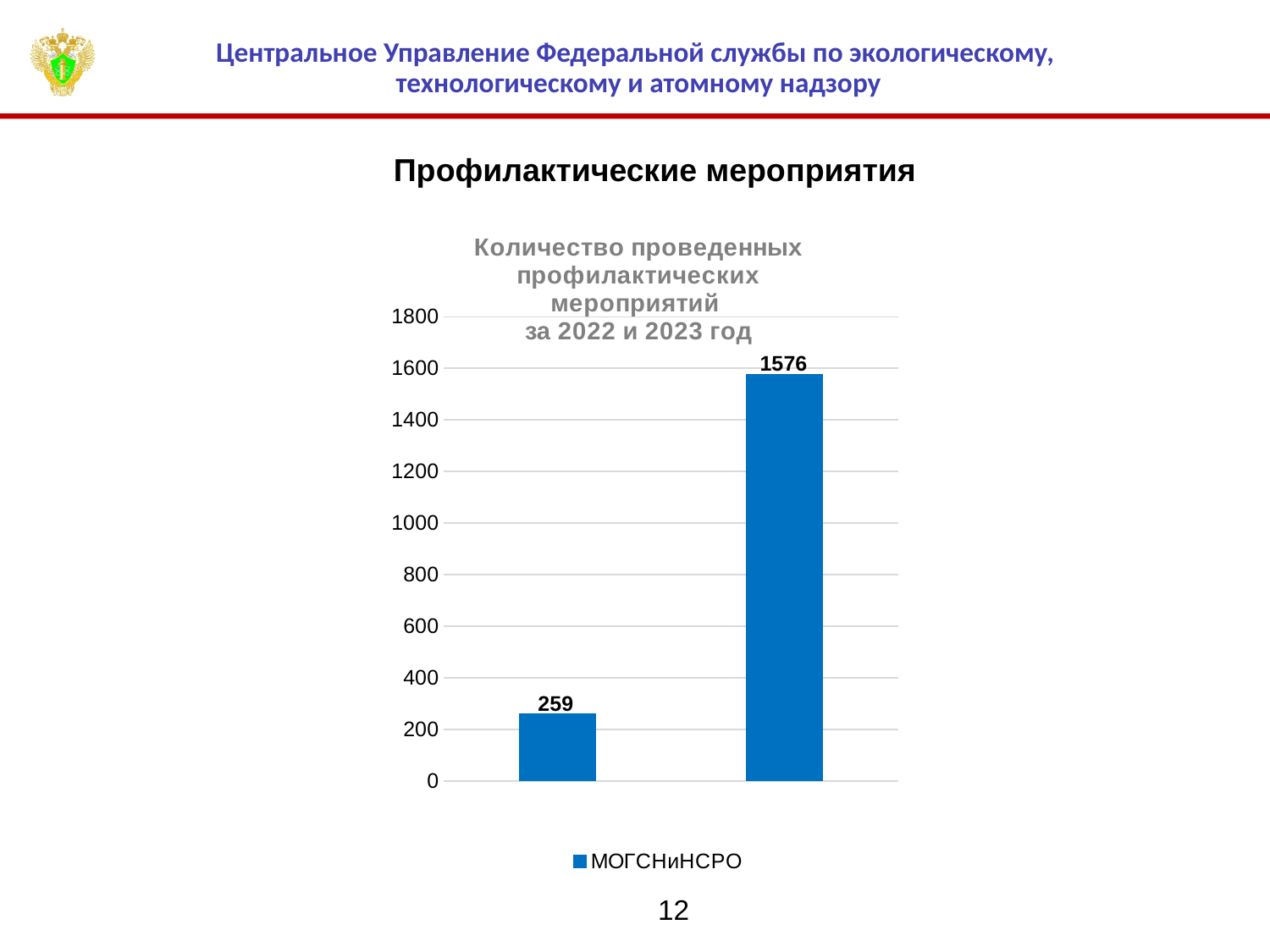
What is the value shown on the left bar of the chart? 259 What series name is shown in the chart legend? МОГСНиНСРО What is the value of the shortest bar in the chart? 259 Which bar is taller, the left one or the right one? the right one What is the value shown on the right bar of the chart? 1576 What kind of chart is shown on the slide? bar chart What is the difference between the right bar (1576) and the left bar (259)? 1317 Is the value of the left bar greater or less than 400? less How many series does the legend list? 1 Is the value of the right bar greater or less than 1400? greater How many bars are plotted in the chart? 2 What is the value of the tallest bar in the chart? 1576